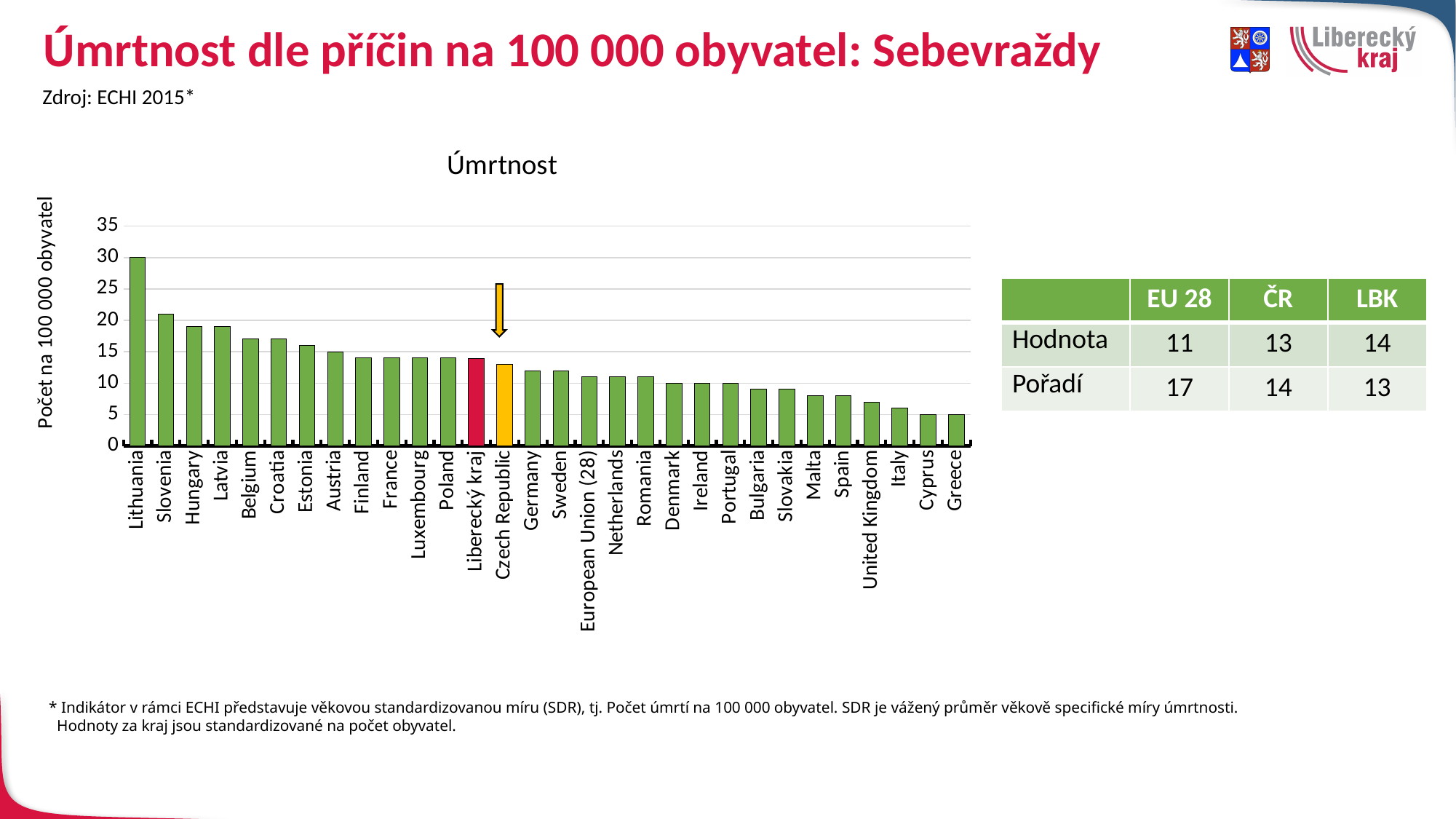
Which category has the highest value on the chart? Lithuania Is the value for Lithuania greater or less than 25? greater Do the values rise or fall moving from left to right along the x axis? fall Is the value for Greece greater or less than 10? less What kind of chart is shown on the slide? bar chart What is the label of the vertical axis of the chart? Počet na 100 000 obyvatel Which has the larger value, Lithuania or Slovenia? Lithuania Is the value for Slovenia greater or less than 20? greater What is the title of the chart? Úmrtnost Which has the larger value, Germany or Greece? Germany How many countries/regions are plotted on the chart? 30